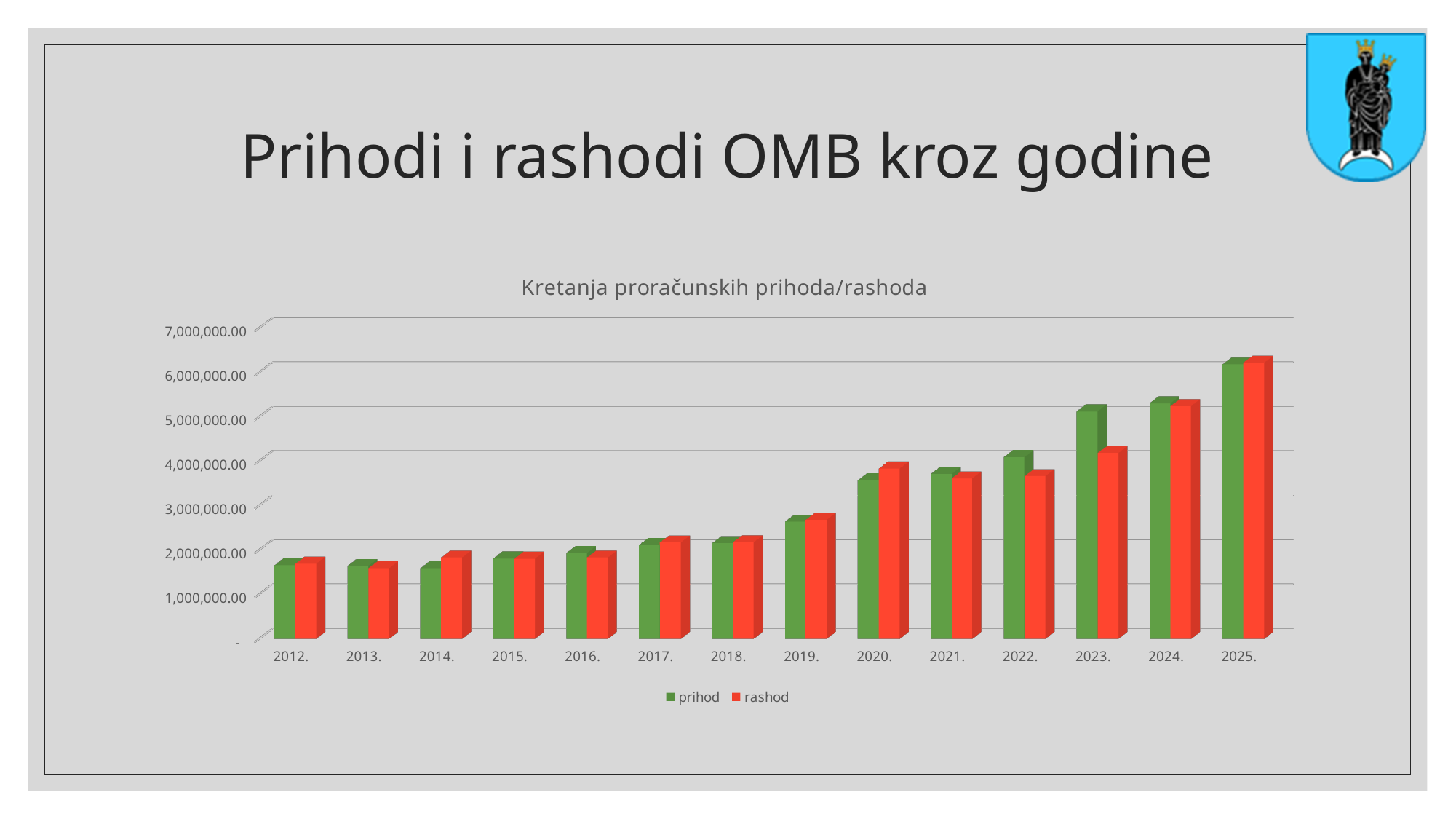
In which year is prihod highest? 2025. How many series does the legend list? 2 What kind of chart is shown on the slide? bar chart Is the value of rashod for 2025. greater or less than 6,000,000.00? greater Is the value of prihod for 2019. greater or less than 3,000,000.00? less In 2023., which is larger, prihod or rashod? prihod Do the prihod values generally rise or fall from 2012. to 2025.? rise In which year is prihod lowest? 2014. In which year is rashod highest? 2025. How many years are shown on the x axis? 14 Is the value of rashod for 2023. greater or less than 4,000,000.00? greater In 2020., which is larger, prihod or rashod? rashod